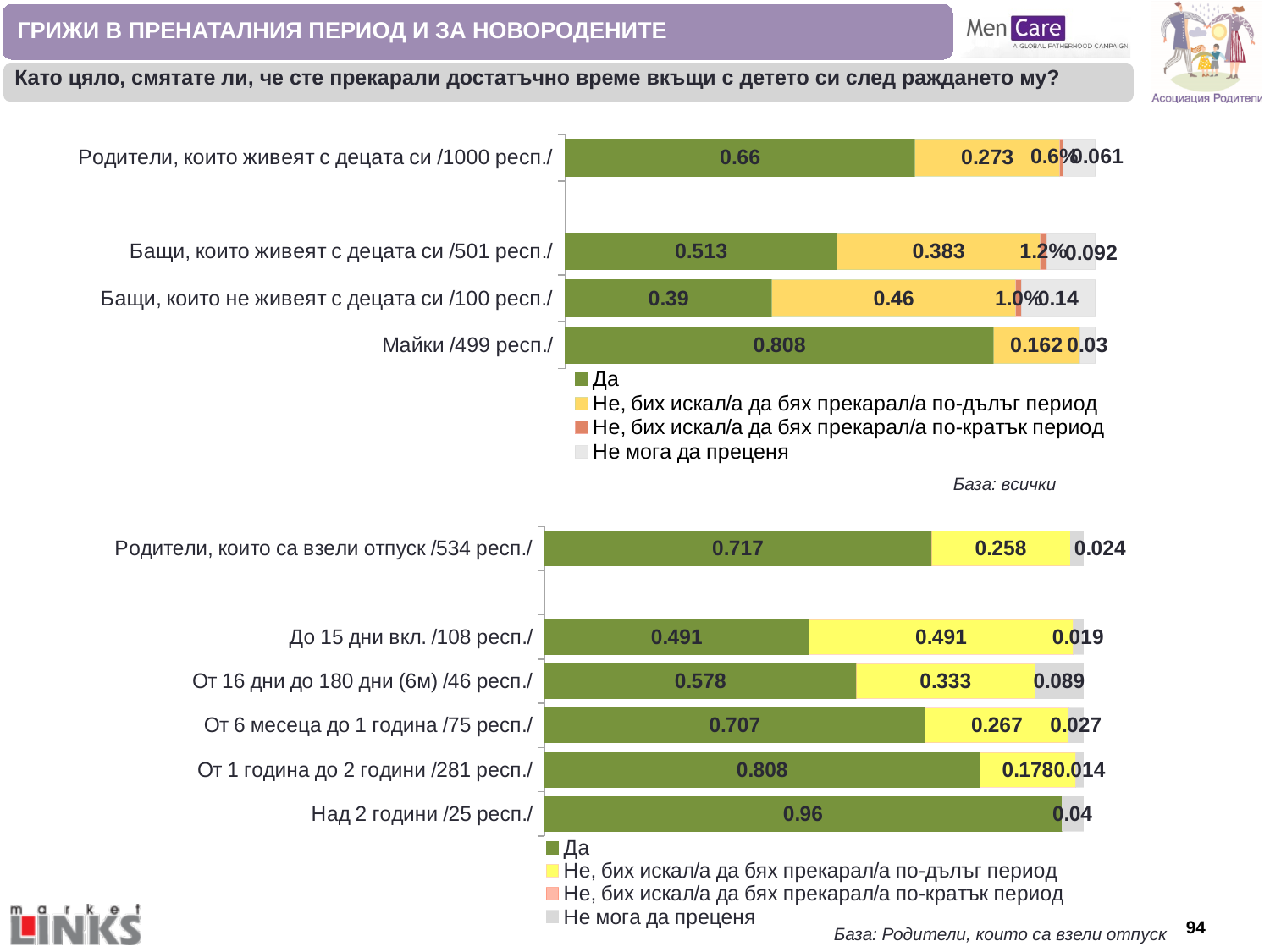
In the top chart, which category has the lowest value for "Да"? Бащи, които не живеят с децата си /100 респ./ In the top chart, what is the value of "Да" for "Майки /499 респ./"? 0.808 In the bottom chart, what is the value of "Да" for "Над 2 години /25 респ./"? 0.96 In the bottom chart, which has the larger "Да" value: "До 15 дни вкл. /108 респ./" or "От 16 дни до 180 дни (6м) /46 респ./"? От 16 дни до 180 дни (6м) /46 респ./ In the top chart, what is the value of "Не, бих искал/а да бях прекарал/а по-дълъг период" for "Бащи, които не живеят с децата си /100 респ./"? 0.46 How many series does the legend of the top chart list? 4 In the bottom chart, which category has the highest value for "Да"? Над 2 години /25 респ./ What kind of chart is the bottom chart? Stacked bar chart In the top chart, which category has the highest value for "Да"? Майки /499 респ./ In the top chart, what is the difference between the "Да" value for "Майки /499 респ./" and the "Да" value for "Бащи, които живеят с децата си /501 респ./"? 0.295 In the bottom chart, do the "Да" values rise or fall going from "До 15 дни вкл." down to "Над 2 години"? Rise How many categories are shown in the bottom chart? 6